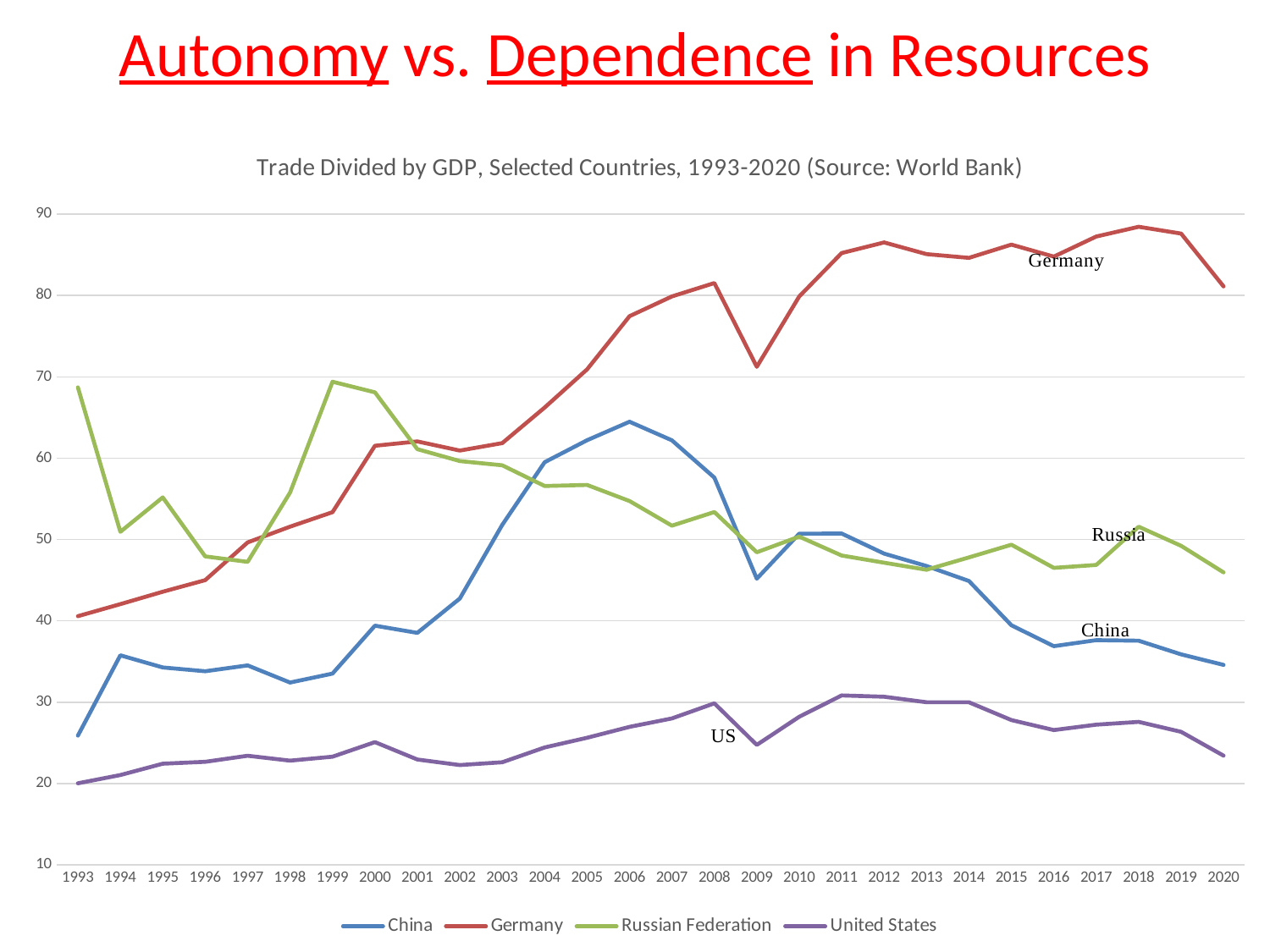
Which country has the lowest value in 2020? United States In which year does the United States line reach its lowest value? 1993 How many years are plotted along the x axis? 28 Which country has the highest value in 2020? Germany What is the title of the chart? Trade Divided by GDP, Selected Countries, 1993-2020 (Source: World Bank) In which year does the China line reach its highest value? 2006 How many series does the legend list? 4 Is the value for China in 2020 greater or less than 40? less Does the Germany line rise or fall from 1993 to 2008? rise What kind of chart is shown on the slide? line chart Is the value for Germany in 2018 greater or less than 80? greater Which is larger in 2006, the value for China or the value for the Russian Federation? China